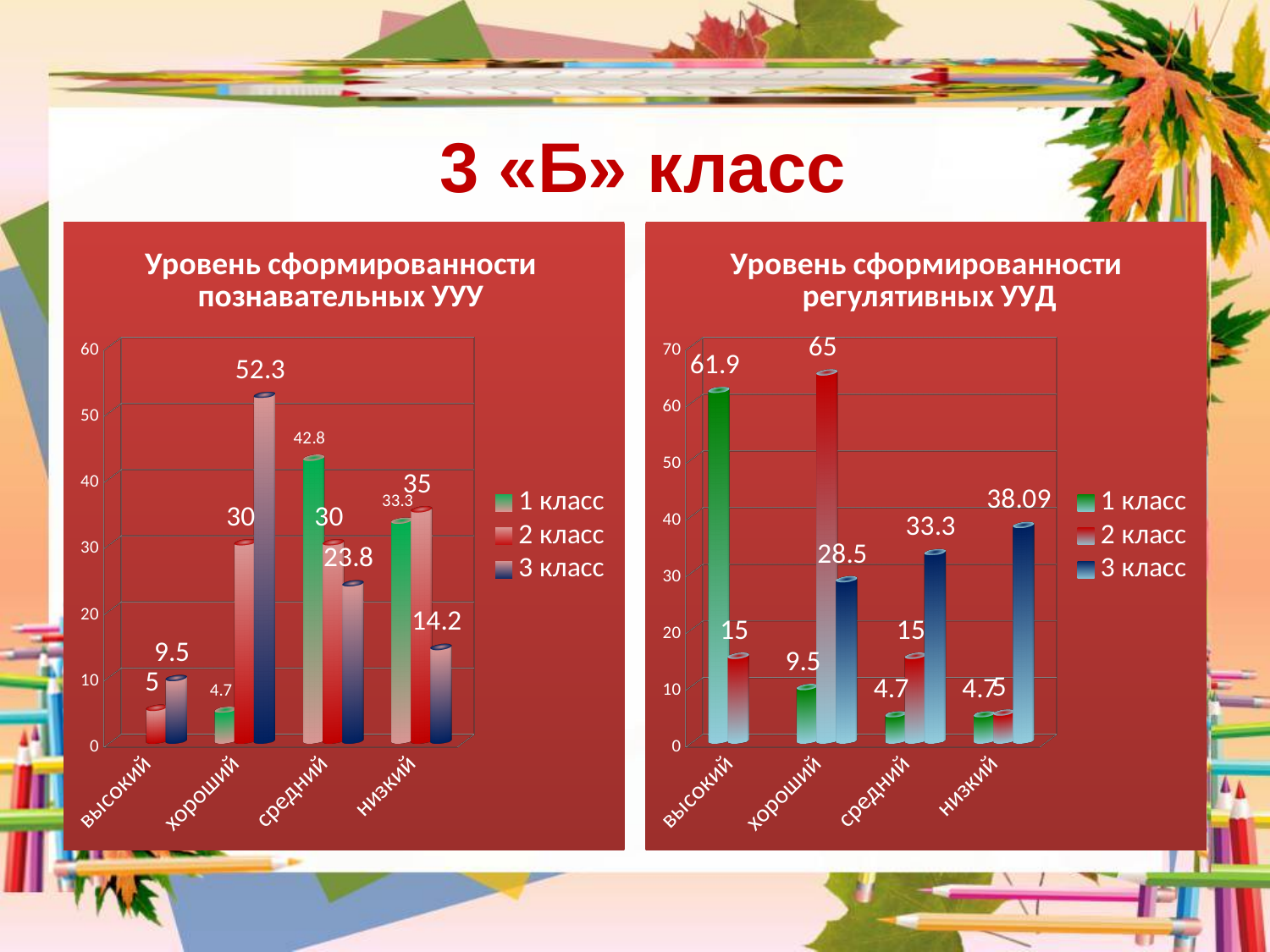
In the right chart (Уровень сформированности регулятивных УУД), what is the value for 3 класс in the низкий category? 38.09 In the left chart (Уровень сформированности познавательных УУУ), what is the value for 1 класс in the средний category? 42.8 How many series does the legend of the right chart (Уровень сформированности регулятивных УУД) list? 3 In the left chart (Уровень сформированности познавательных УУУ), which category has the highest value for 3 класс? хороший In the right chart (Уровень сформированности регулятивных УУД), which category has the highest value for 1 класс? высокий In the left chart (Уровень сформированности познавательных УУУ), what is the difference between the 2 класс and 3 класс values in the высокий category? 4.5 In the left chart (Уровень сформированности познавательных УУУ), what is the value for 3 класс in the хороший category? 52.3 In the right chart (Уровень сформированности регулятивных УУД), what is the difference between the 3 класс values for средний and хороший? 4.8 In the left chart (Уровень сформированности познавательных УУУ), what is the value for 3 класс in the низкий category? 14.2 In the left chart (Уровень сформированности познавательных УУУ), which is larger in the низкий category: 1 класс or 2 класс? 2 класс What type of chart is the left chart (Уровень сформированности познавательных УУУ)? Bar chart In the right chart (Уровень сформированности регулятивных УУД), what is the value for 2 класс in the хороший category? 65